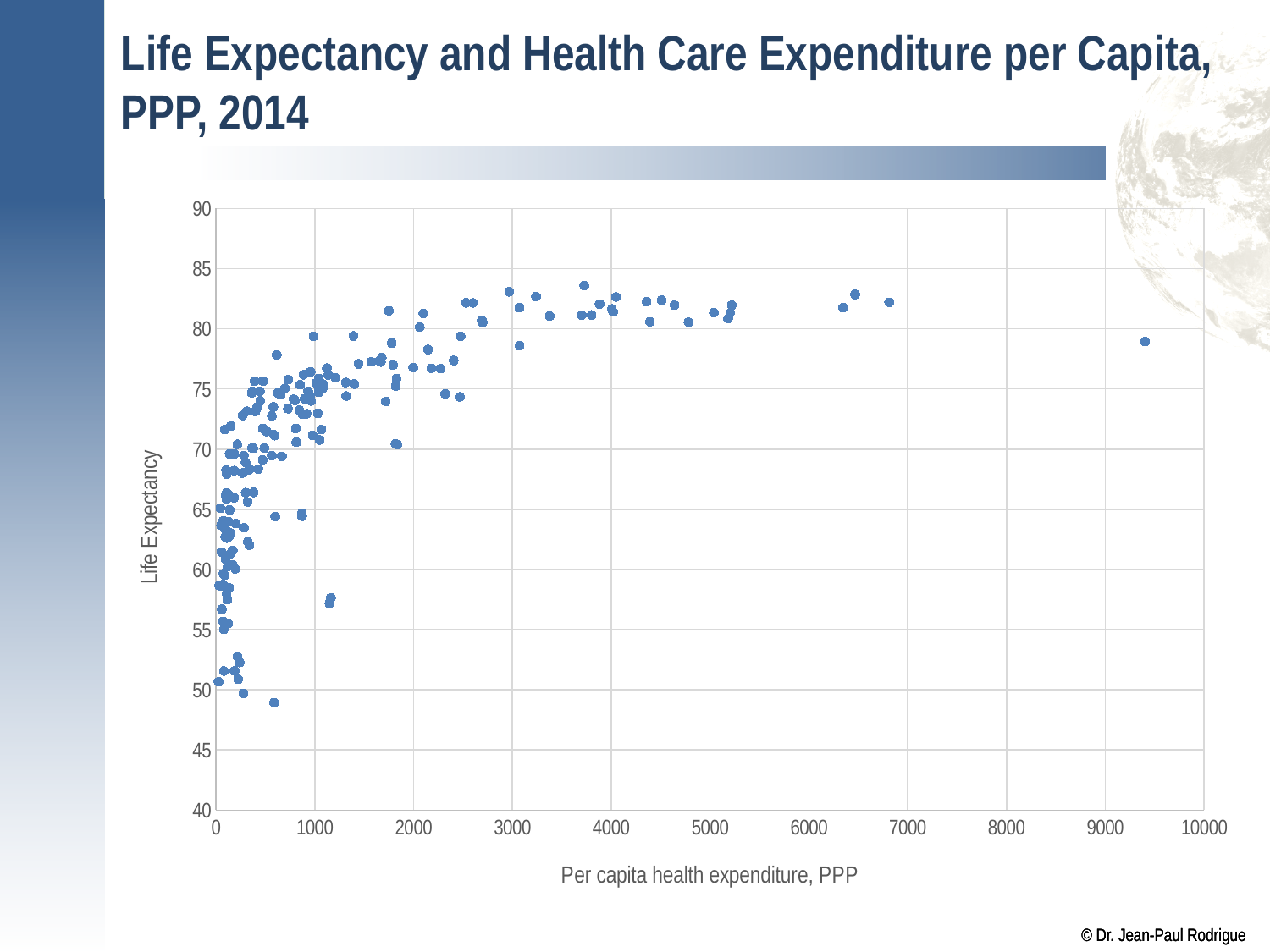
Is the life expectancy of the point with the highest per capita health expenditure (around 9400) greater or less than 85? less What is the title of the chart? Life Expectancy and Health Care Expenditure per Capita, PPP, 2014 What kind of chart is shown on the slide? Scatter plot What is the label of the horizontal axis? Per capita health expenditure, PPP As per capita health expenditure increases along the x axis, does life expectancy generally rise or fall? Rise Is the lowest life expectancy plotted on the chart greater or less than 55? less Is the life expectancy of the point with the highest per capita health expenditure (around 9400) greater or less than 70? greater